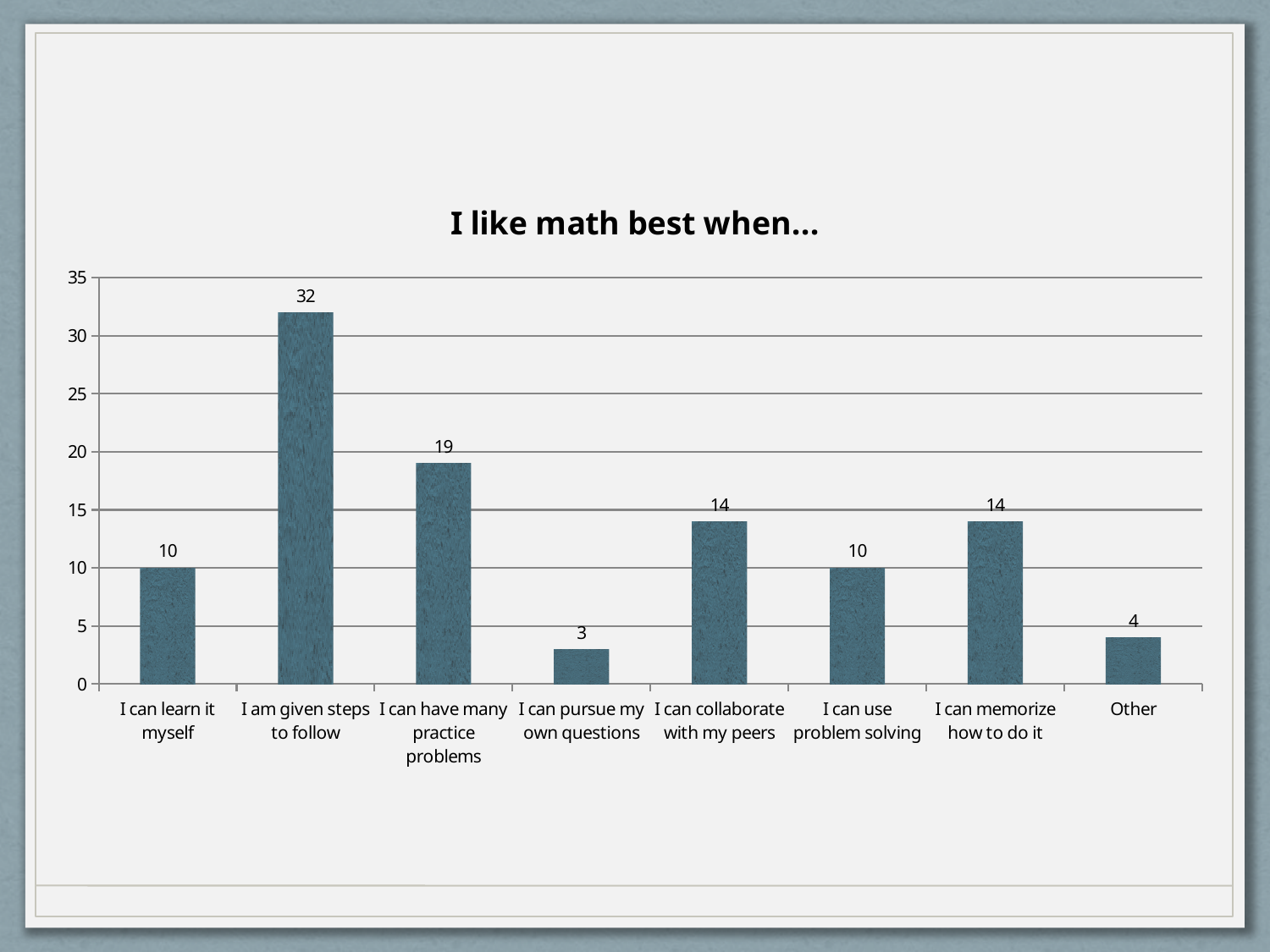
Is the value for "I can have many practice problems" greater or less than 15? greater How many categories are shown on the x axis? 8 What is the value for "I am given steps to follow"? 32 What kind of chart is shown on the slide? bar chart What is the value for "I can pursue my own questions"? 3 What is the difference between "I am given steps to follow" and "I can have many practice problems"? 13 Which category has the highest value? I am given steps to follow What is the title of the chart? I like math best when... Which category has the lowest value? I can pursue my own questions Which is larger, "I can collaborate with my peers" or "I can use problem solving"? I can collaborate with my peers What is the value for "I can memorize how to do it"? 14 What is the value for "Other"? 4